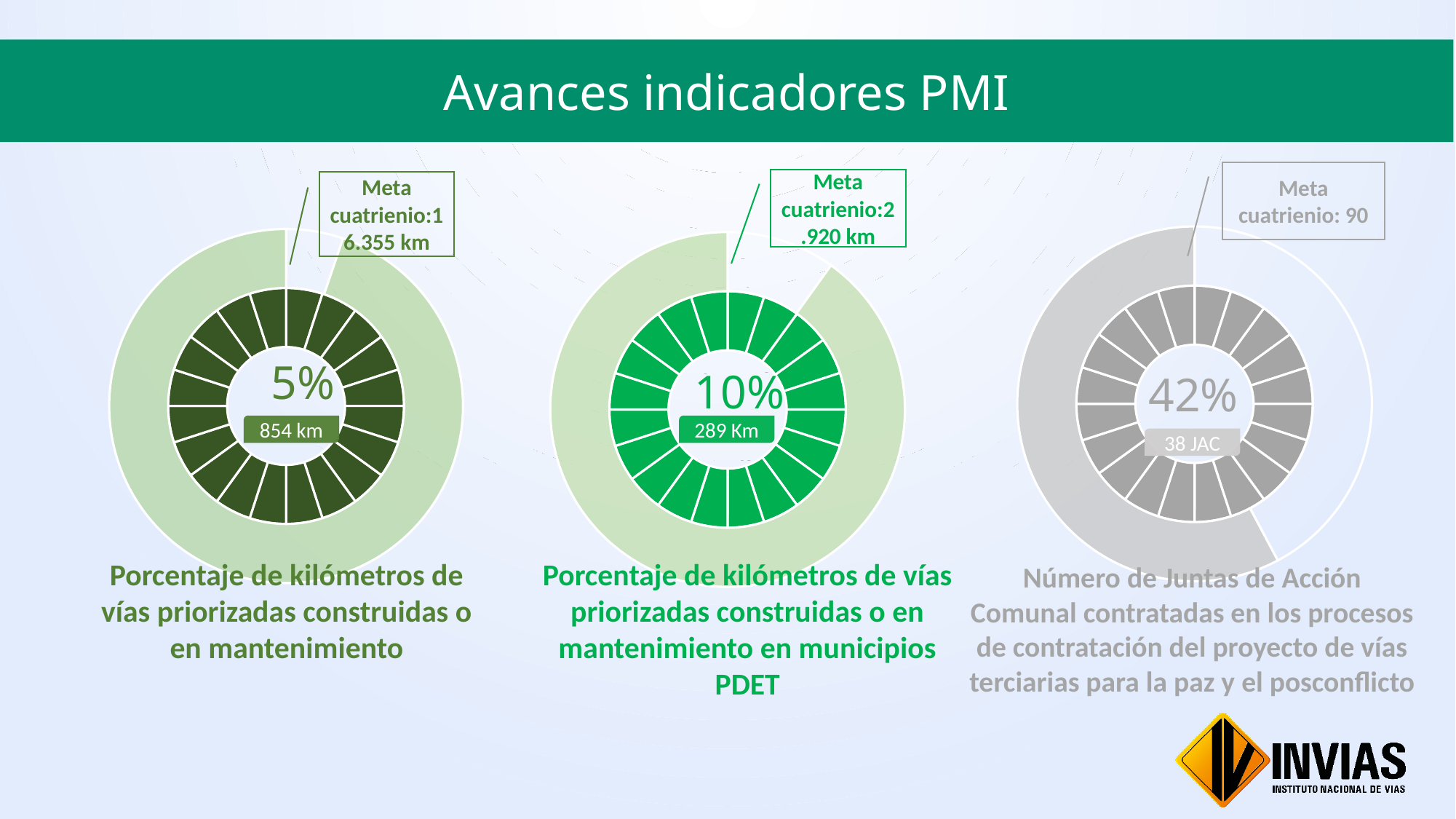
What is the 'Meta cuatrienio' for the right chart (Juntas de Acción Comunal)? 90 What is the difference in percentage points between the right chart (42%) and the middle chart (10%)? 32 How many kilometres are shown in the centre of the middle chart (municipios PDET)? 289 Km How many JAC remain to reach the meta cuatrienio of 90 in the right chart, given 38 JAC achieved? 52 How many JAC are reported in the right chart? 38 JAC What is the 'Meta cuatrienio' for the middle chart (municipios PDET)? 2.920 km What percentage is shown in the centre of the left chart (Porcentaje de kilómetros de vías priorizadas construidas o en mantenimiento)? 5% How many donut charts are shown on the slide? 3 Which is larger: the percentage in the middle chart or the percentage in the left chart? The middle chart (10%) Which of the three charts shows the lowest percentage? Porcentaje de kilómetros de vías priorizadas construidas o en mantenimiento (5%) Which of the three charts shows the highest percentage? Número de Juntas de Acción Comunal contratadas (42%) What value is shown in the centre of the right chart (Número de Juntas de Acción Comunal contratadas)? 42%